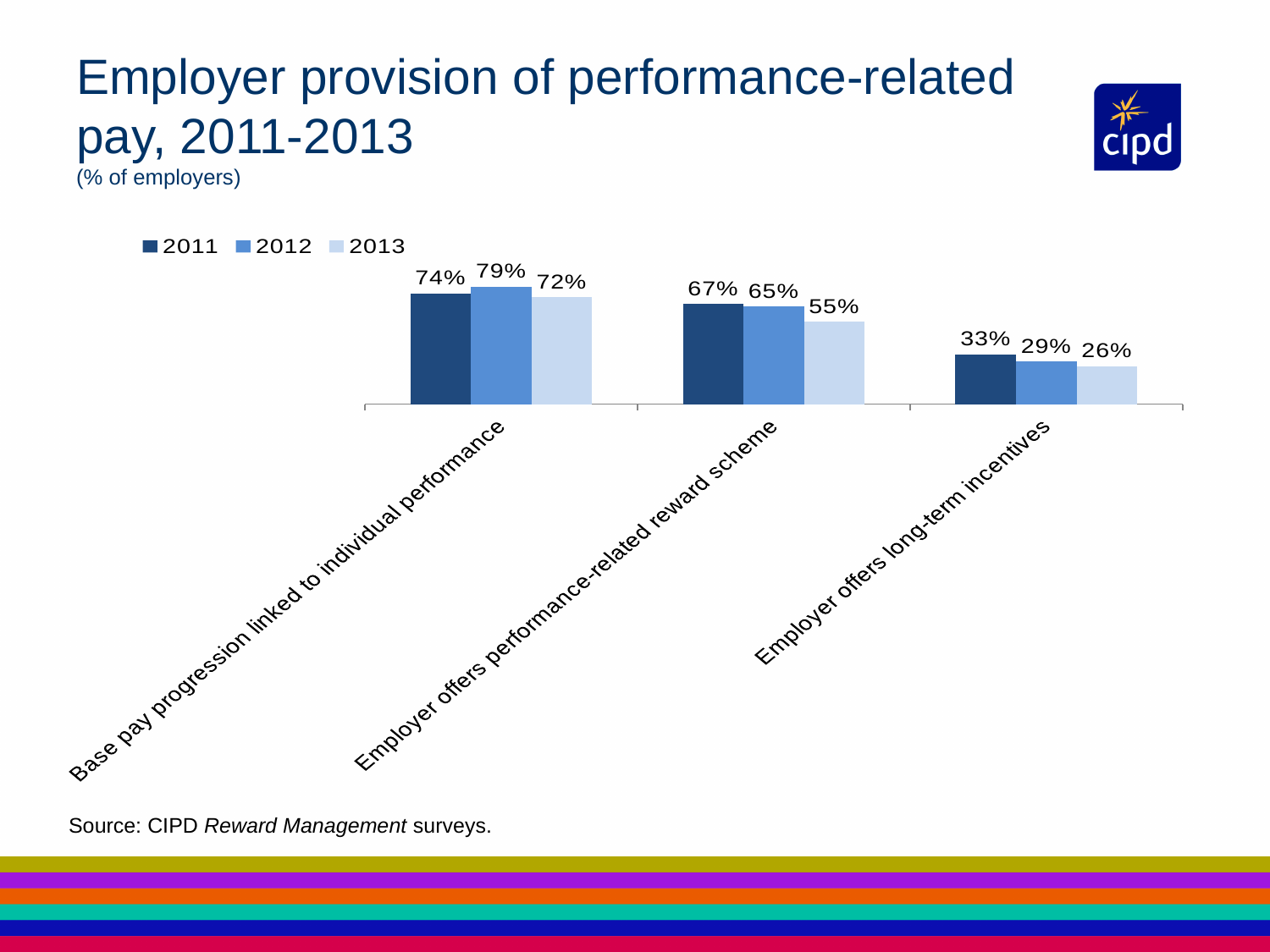
How many categories are shown on the x axis? 3 Do the values for 'Employer offers performance-related reward scheme' rise or fall from 2011 to 2013? Fall What is the 2013 value for 'Employer offers performance-related reward scheme'? 55% What percentage of employers had base pay progression linked to individual performance in 2012? 79% Which category has the lowest value in 2013? Employer offers long-term incentives Which is larger: the 2012 value for 'Employer offers long-term incentives' or the 2013 value for the same category? 2012 What kind of chart is shown on the slide? Bar chart What is the 2011 value for 'Employer offers long-term incentives'? 33% Which category has the highest value in 2011? Base pay progression linked to individual performance What are the three series listed in the legend? 2011, 2012, 2013 How many series does the legend list? 3 What is the difference between the 2011 and 2013 values for 'Employer offers performance-related reward scheme'? 12 percentage points